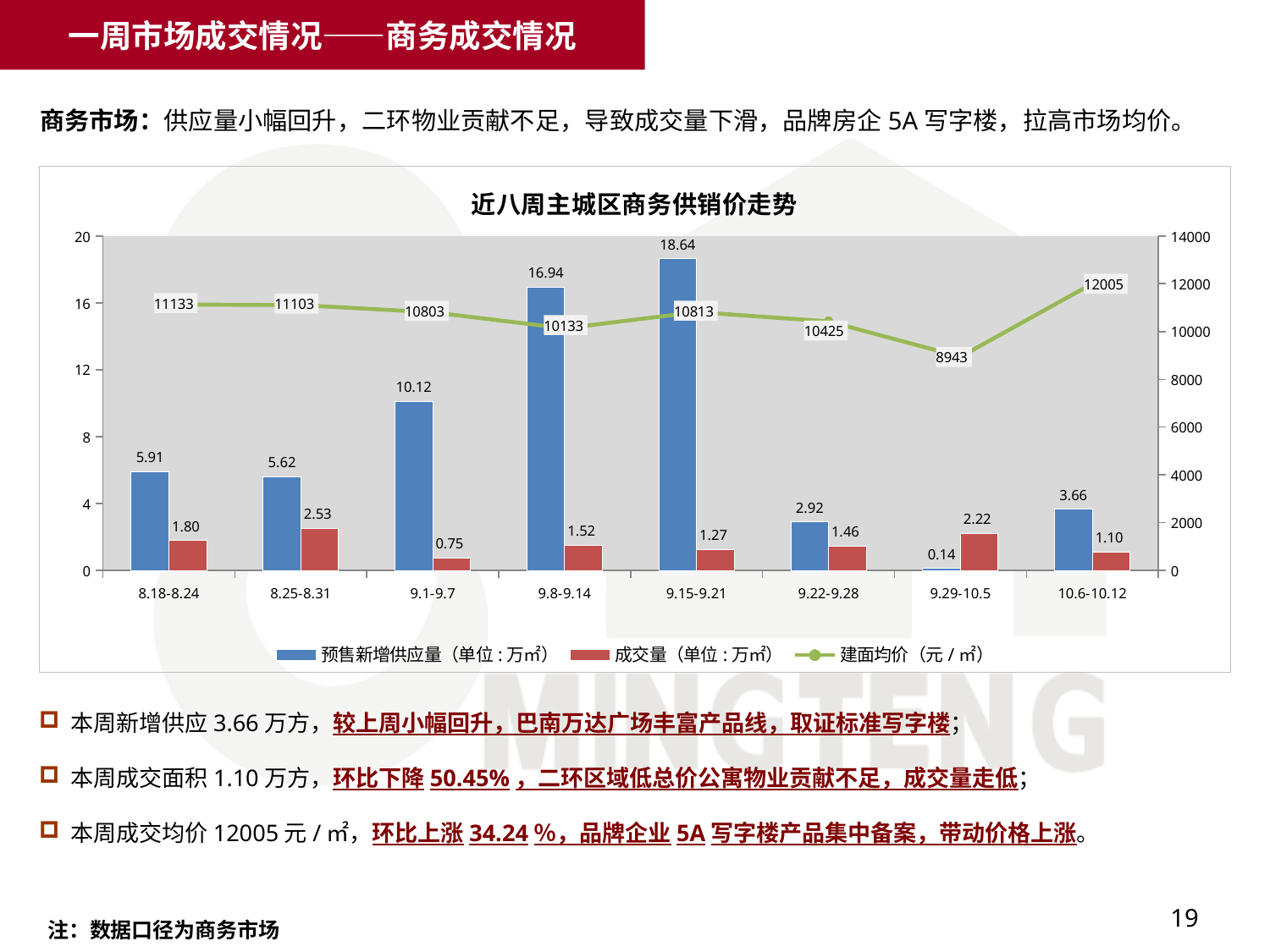
How many weeks are shown on the x axis of the chart? 8 Which week has the lowest 建面均价? 9.29-10.5 What is the difference in 预售新增供应量 between the weeks 9.15-9.21 and 9.8-9.14? 1.70 What is the 成交量 value for the week 10.6-10.12? 1.10 What is the 预售新增供应量 value for the week 9.15-9.21? 18.64 What is the 建面均价 value for the week 9.29-10.5? 8943 What kind of chart is used to show 建面均价? line chart Which week has the lowest 成交量? 9.1-9.7 How many series does the chart legend list? 3 Which is larger, the 成交量 for 8.25-8.31 or for 9.29-10.5? 8.25-8.31 Which week has the highest 预售新增供应量? 9.15-9.21 What is the title of the chart? 近八周主城区商务供销价走势